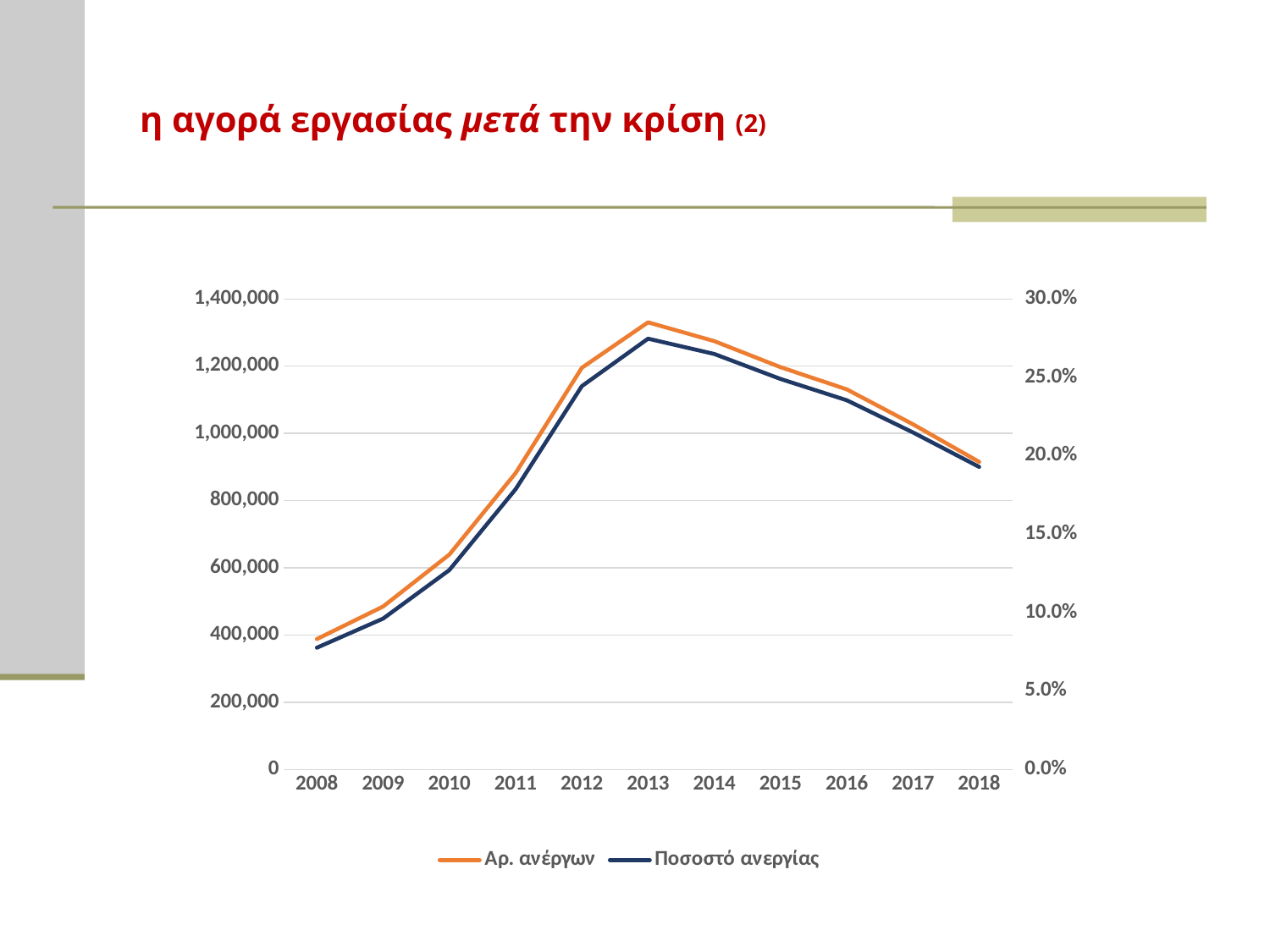
Does the Ποσοστό ανεργίας series rise or fall between 2013 and 2018? fall Which series is drawn in orange? Αρ. ανέργων What kind of chart is shown on the slide? line chart Is the value of Αρ. ανέργων in 2018 greater or less than 1,000,000? less Is the value of Αρ. ανέργων in 2013 greater or less than 1,200,000? greater Is the value of Ποσοστό ανεργίας in 2008 greater or less than 10.0%? less How many years are shown on the x axis? 11 In which year is the Ποσοστό ανεργίας series at its lowest? 2008 Which year has the larger value for Αρ. ανέργων, 2010 or 2016? 2016 Does the Αρ. ανέργων series rise or fall between 2008 and 2013? rise How many series does the legend list? 2 In which year does the Αρ. ανέργων series reach its highest value? 2013